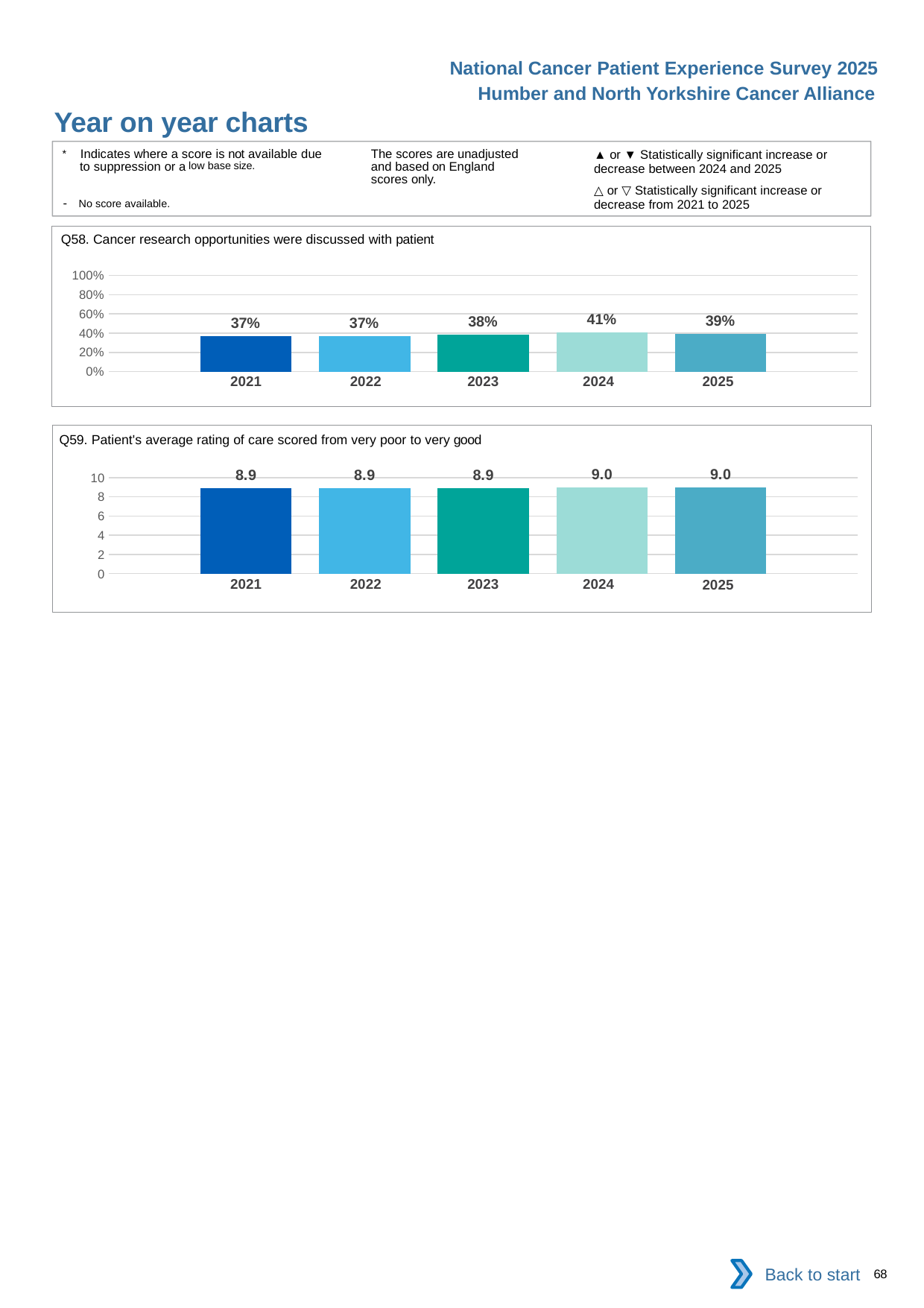
In the Q59 chart, what is the value for 2022? 8.9 In the Q59 chart, what is the value for 2025? 9.0 In the Q58 chart, what is the value for 2024? 41% In the Q58 chart, which year has the highest value? 2024 What is the title of the top chart? Q58. Cancer research opportunities were discussed with patient In the Q59 chart, is the value for 2023 greater or less than 8? greater In the Q58 chart, how many years are plotted? 5 In the Q58 chart, what is the difference between the 2024 and 2025 values? 2% In the Q58 chart, what is the value for 2021? 37% In the Q58 chart, is the value for 2023 greater or less than 60%? less What kind of chart is the Q59 chart? Bar chart In the Q59 chart, what is the difference between the 2024 and 2021 values? 0.1